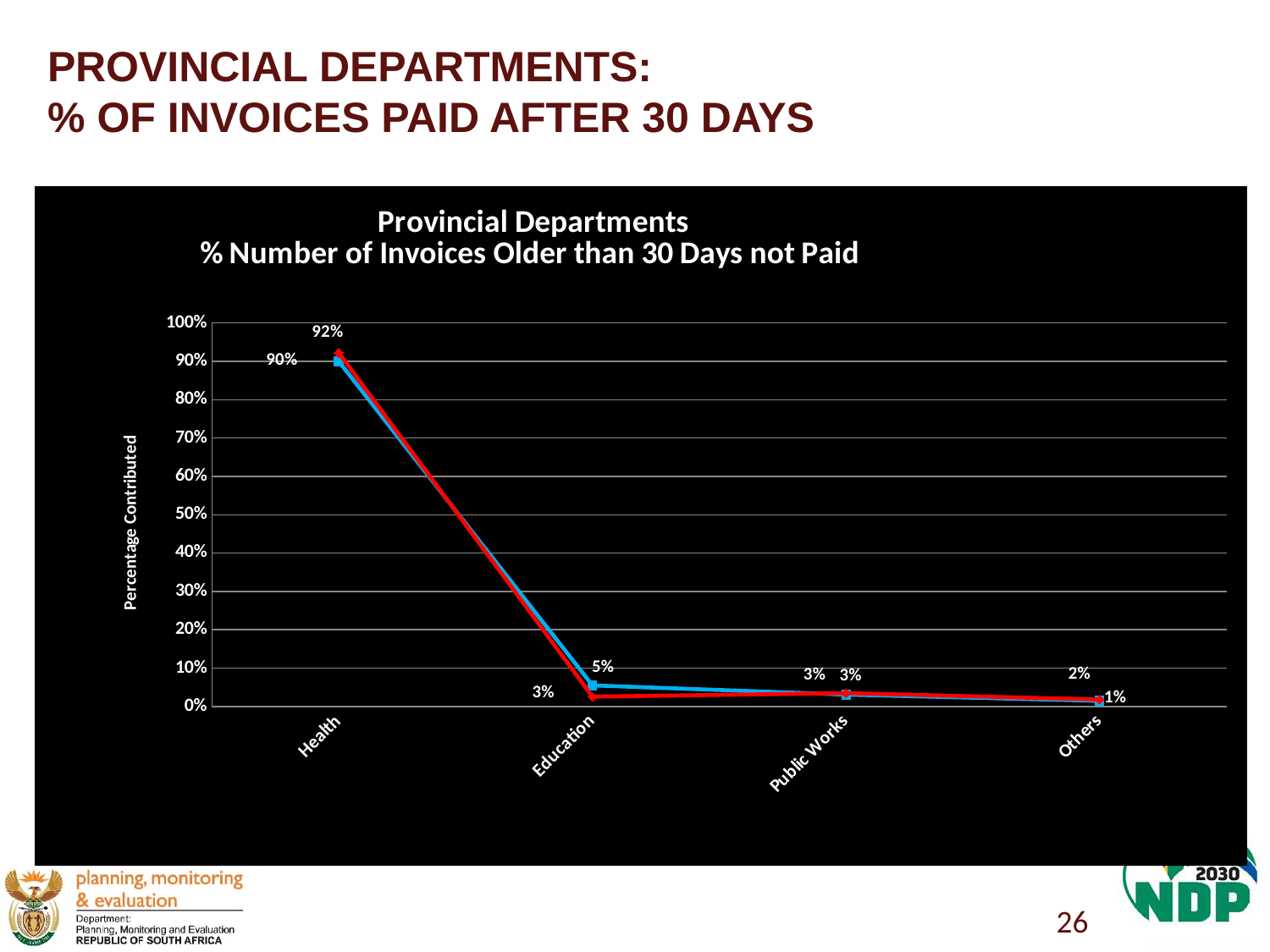
Do the values rise or fall moving from Health to Others along the x axis? Fall Which category has the lowest values in the chart? Others What is the difference between the red line's value (92%) and the blue line's value (90%) for Health? 2 percentage points What is the title of the y axis of the chart? Percentage Contributed How many categories are shown on the x axis of the chart? 4 What kind of chart is shown on the slide? Line chart Which category has the highest values in the chart? Health What value does the red line show for Health? 92% What value does the blue line show for Health? 90% Is the value for Education greater or less than 10%? less What value is labelled for Public Works on both lines? 3% Which category has larger values, Health or Education? Health